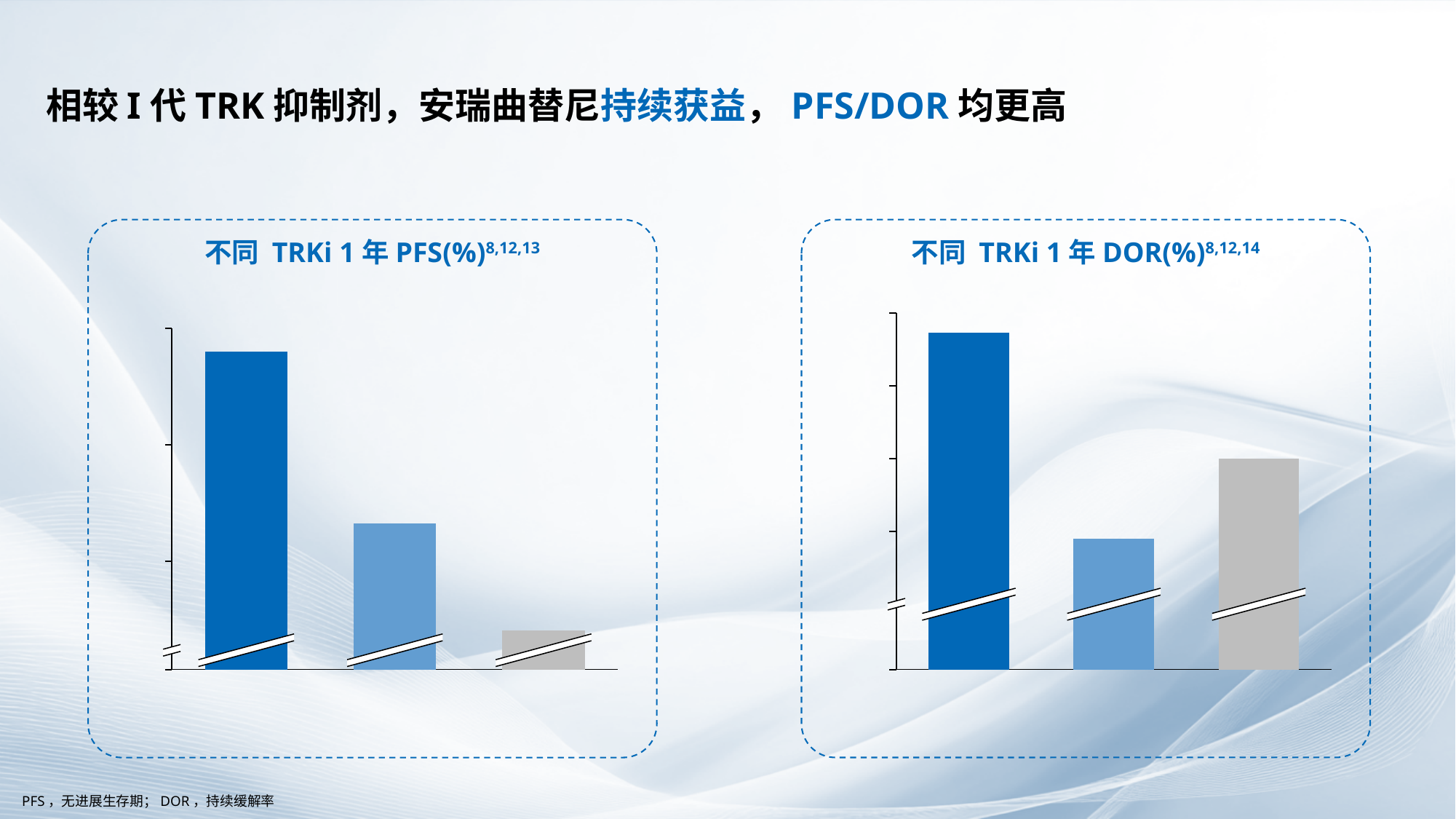
In the left chart, 不同 TRKi 1 年 PFS(%), which bar is the shortest: the first (dark blue), second (light blue) or third (grey)? the third (grey) In the right chart, 不同 TRKi 1 年 DOR(%), which bar is the tallest: the first (dark blue), second (light blue) or third (grey)? the first (dark blue) What is the title of the chart on the left side of the slide? 不同 TRKi 1 年 PFS(%) In the right chart, 不同 TRKi 1 年 DOR(%), is the grey bar taller or shorter than the light blue bar? taller What kind of chart is shown in the right panel titled 不同 TRKi 1 年 DOR(%)? bar chart In the left chart, 不同 TRKi 1 年 PFS(%), is the light blue bar taller or shorter than the grey bar? taller What is the title of the chart on the right side of the slide? 不同 TRKi 1 年 DOR(%) How many bars are plotted in the left chart, 不同 TRKi 1 年 PFS(%)? 3 In the right chart, 不同 TRKi 1 年 DOR(%), which bar is the shortest: the first (dark blue), second (light blue) or third (grey)? the second (light blue) In the left chart, 不同 TRKi 1 年 PFS(%), which bar is the tallest: the first (dark blue), second (light blue) or third (grey)? the first (dark blue) What kind of chart is shown in the left panel titled 不同 TRKi 1 年 PFS(%)? bar chart How many bars are plotted in the right chart, 不同 TRKi 1 年 DOR(%)? 3